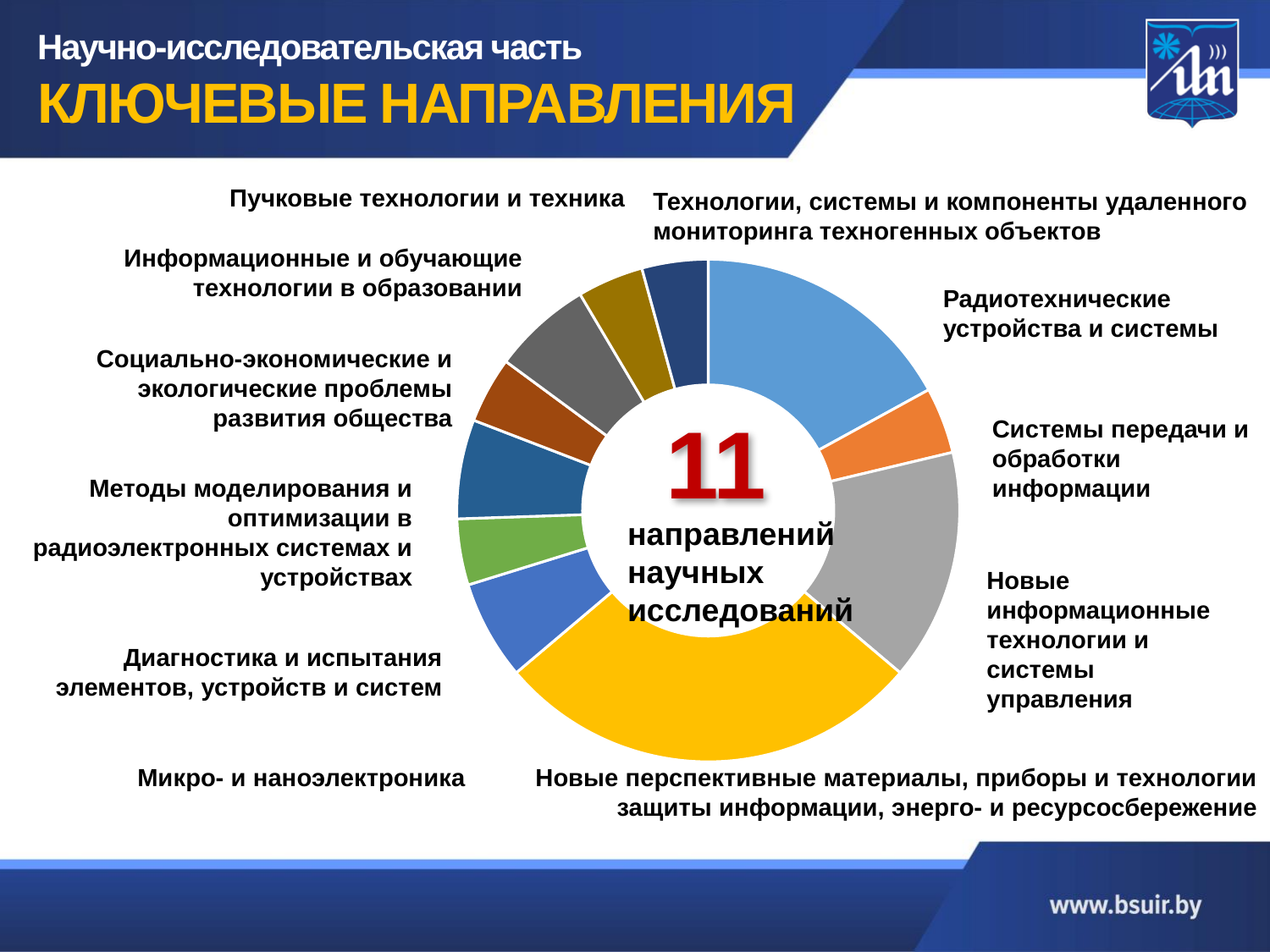
Which segment is larger in the donut chart: the light blue one or the orange one? The light blue one Which segment is larger in the donut chart: the grey one or the green one? The grey one What number is printed in the centre of the donut chart? 11 What colour is the largest segment of the donut chart? Yellow How many segments does the donut chart have? 11 What kind of chart is shown on the slide? Donut (pie) chart Which segment is larger in the donut chart: the yellow one or the grey one? The yellow one What text accompanies the number in the centre of the donut chart? направлений научных исследований Which research direction has the largest segment in the donut chart? Новые перспективные материалы, приборы и технологии защиты информации, энерго- и ресурсосбережение